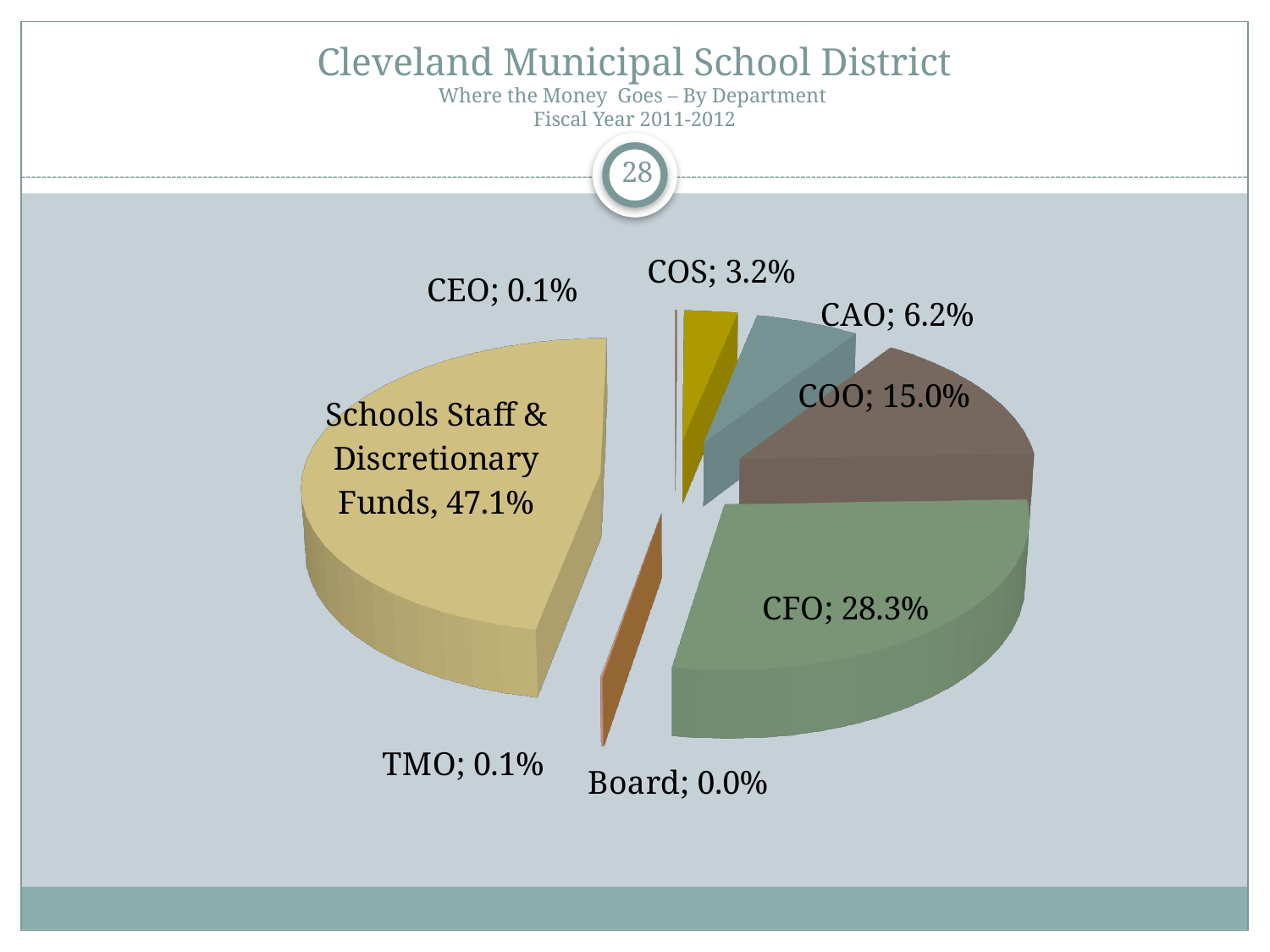
What is the value shown for COO? 15.0% What is the difference between the CFO share and the COO share? 13.3% Which is larger, the CAO share or the COS share? CAO How many categories are shown in the pie chart? 8 What fiscal year does the chart title refer to? Fiscal Year 2011-2012 What kind of chart is shown on the slide? Pie chart Which category has the largest share of the pie? Schools Staff & Discretionary Funds What share of the pie does the CFO slice represent? 28.3% What is the value shown for CAO? 6.2% What percentage is shown for Schools Staff & Discretionary Funds? 47.1% Which category has the smallest share of the pie? Board What is the combined share of CEO and TMO? 0.2%